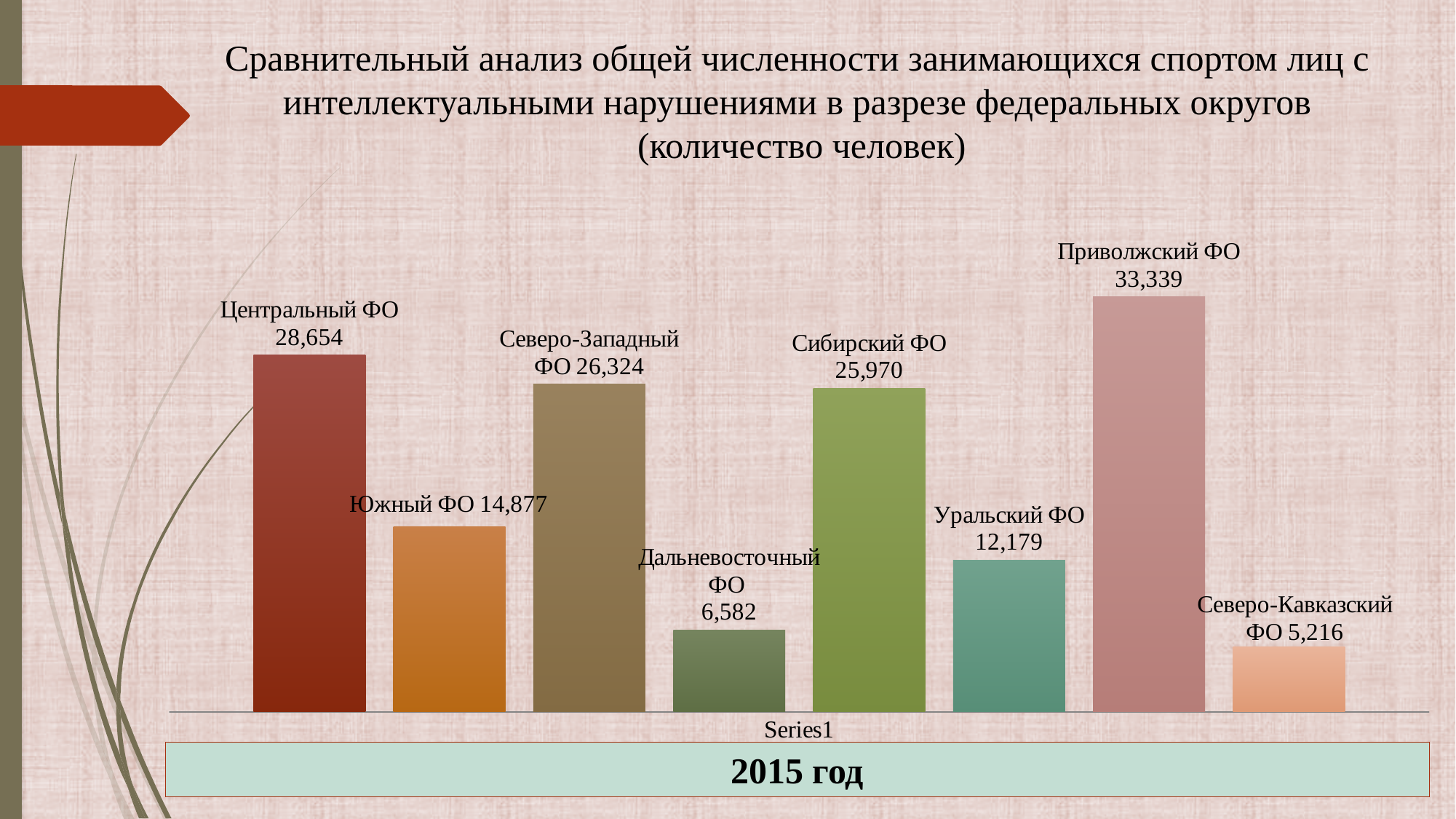
Which is larger, the value for Уральский ФО or the value for Южный ФО? Южный ФО What is the value for Уральский ФО? 12,179 What is the difference between the values for Приволжский ФО and Центральный ФО? 4,685 What kind of chart is shown on the slide? Bar chart Which federal district has the lowest value? Северо-Кавказский ФО How many federal districts (bars) are shown in the chart? 8 What year is indicated in the box below the chart? 2015 год What is the value for Северо-Кавказский ФО? 5,216 Which is larger, the value for Северо-Западный ФО or the value for Сибирский ФО? Северо-Западный ФО What is the value for Центральный ФО? 28,654 Which federal district has the highest value? Приволжский ФО What is the difference between the values for Южный ФО and Дальневосточный ФО? 8,295